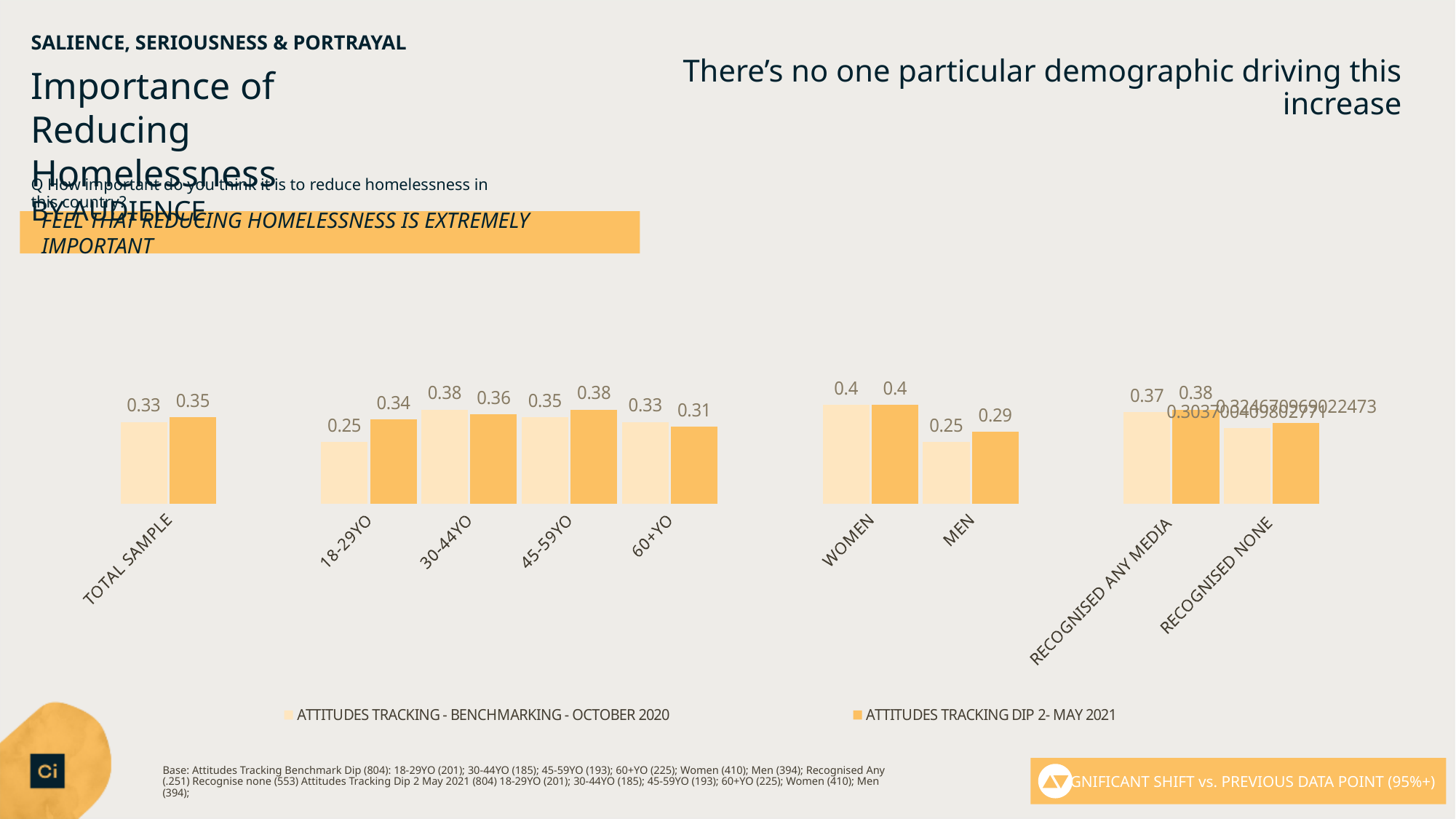
Which category has the lowest value in the Attitudes Tracking Dip 2 - May 2021 series? Men What is the value for Women in the Attitudes Tracking Dip 2 - May 2021 series? 0.4 What is the difference between the May 2021 and October 2020 values for 18-29YO? 0.09 What is the value for Men in the Attitudes Tracking - Benchmarking - October 2020 series? 0.25 How many series does the legend list? 2 What is the value for Total Sample in the Attitudes Tracking Dip 2 - May 2021 series? 0.35 What is the value for Recognised Any Media in the Attitudes Tracking Dip 2 - May 2021 series? 0.38 What kind of chart is shown on the slide? Bar chart Which category has the highest value in the Attitudes Tracking Dip 2 - May 2021 series? Women What is the value for 18-29YO in the Attitudes Tracking - Benchmarking - October 2020 series? 0.25 For 30-44YO, which series has the larger value: October 2020 or May 2021? October 2020 How many categories are shown on the x axis? 9